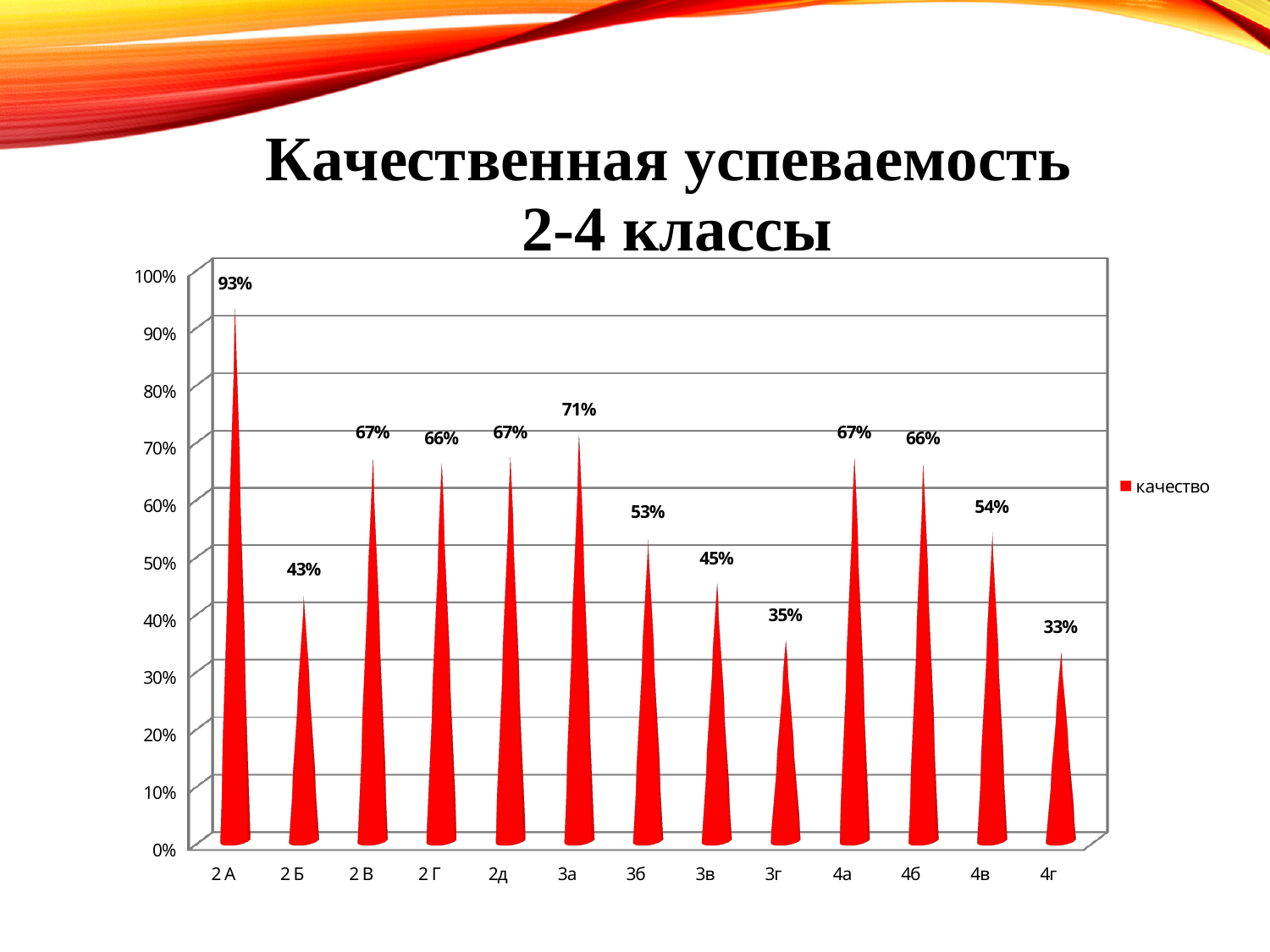
Which class has the lowest value? 4г What is the value for 3б? 53% What is the value for 2 А? 93% What is the value for 4в? 54% What kind of chart is shown? bar chart Which class has the highest value? 2 А How many series does the legend list? 1 What is the difference between the values for 3а and 3г? 36% How many classes are shown on the x axis? 13 Which is larger, the value for 3в or the value for 4в? 4в What is the difference between the values for 2 А and 2 Б? 50% What is the title of the chart? Качественная успеваемость 2-4 классы